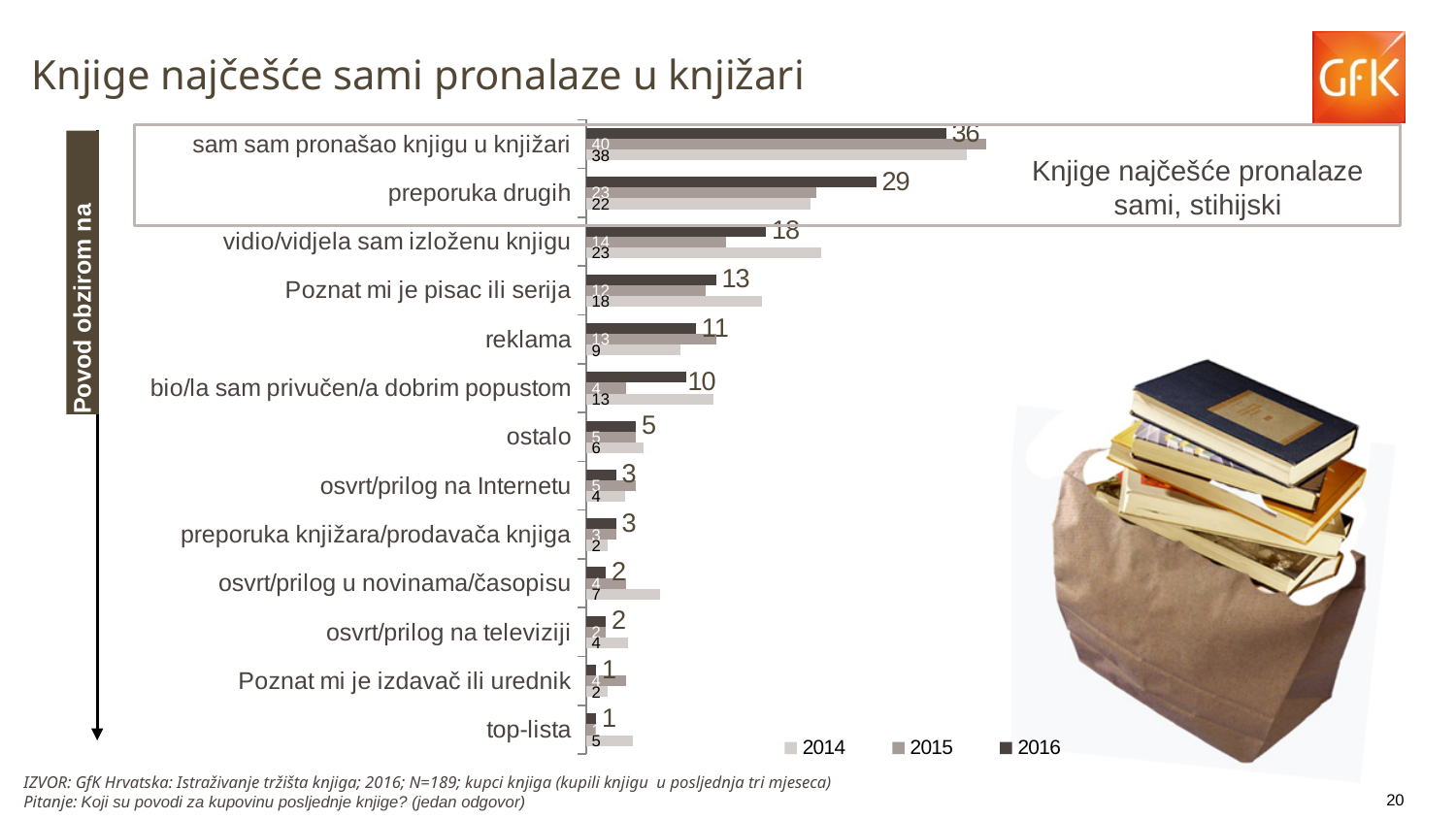
How many series does the legend list? 3 What is the 2016 value for "sam sam pronašao knjigu u knjižari"? 36 What is the 2016 value for "reklama"? 11 What is the difference between the 2016 values for "sam sam pronašao knjigu u knjižari" and "preporuka drugih"? 7 What is the 2016 value for "ostalo"? 5 In 2016, which is larger: "Poznat mi je pisac ili serija" or "bio/la sam privučen/a dobrim popustom"? Poznat mi je pisac ili serija What is the 2014 value for "sam sam pronašao knjigu u knjižari"? 38 What kind of chart is shown on the slide? bar chart How many categories are shown in the chart? 13 Which category has the highest 2016 value? sam sam pronašao knjigu u knjižari What are the entries in the chart's legend? 2014, 2015, 2016 What is the 2016 value for "preporuka drugih"? 29